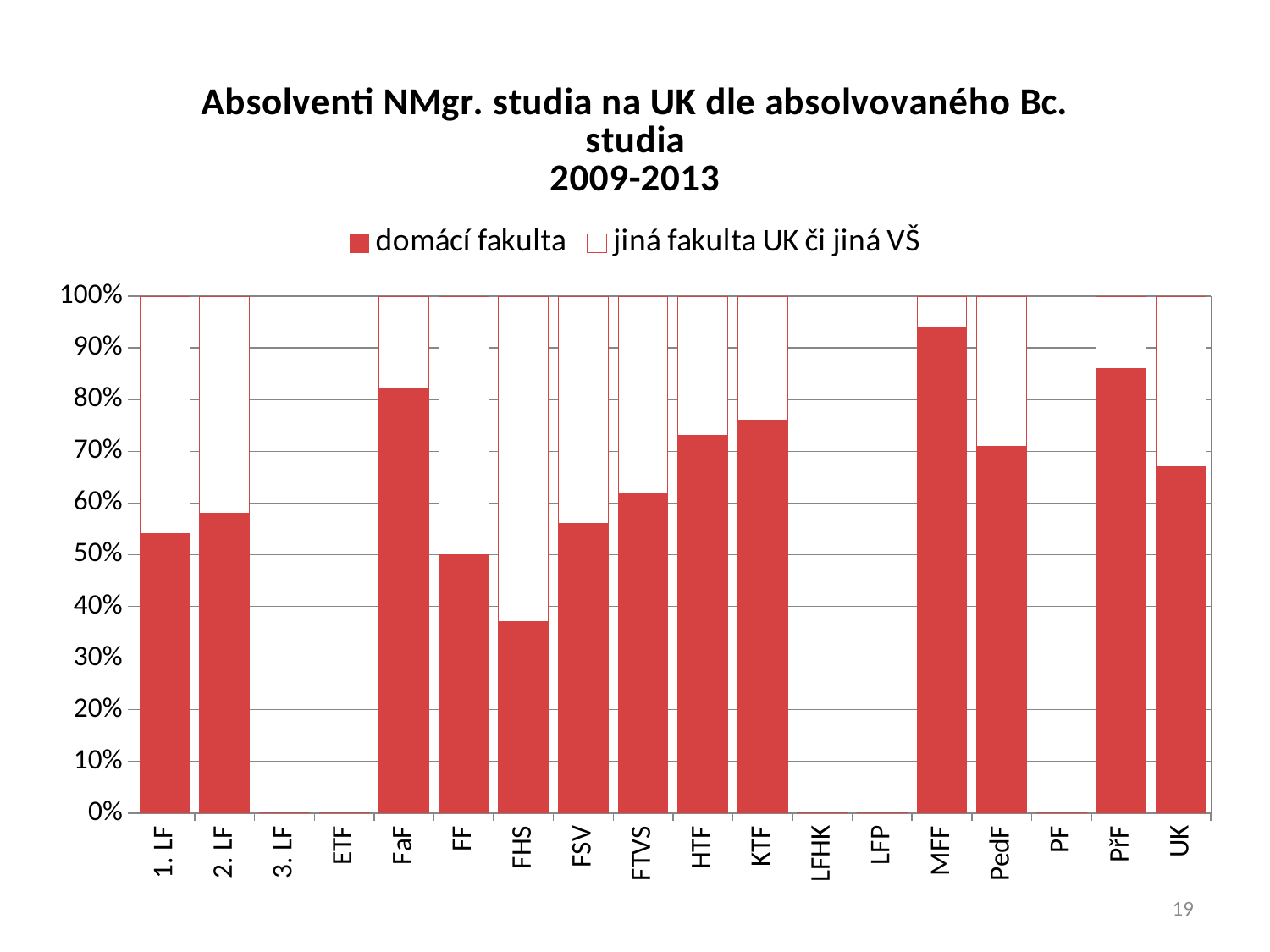
How many series does the legend list? 2 What is the total of the stacked bar for FaF? 100% How many categories are shown on the x axis? 18 Is the 'domácí fakulta' value for MFF greater or less than 90%? greater Is the 'domácí fakulta' value for FHS greater or less than 40%? less What kind of chart is shown on the slide? bar chart Which has the larger 'domácí fakulta' value, MFF or PřF? MFF Is the 'domácí fakulta' value for FaF greater or less than 80%? greater Which category has the highest value for 'domácí fakulta'? MFF Among the categories with a visible bar, which has the lowest value for 'domácí fakulta'? FHS Which has the larger 'domácí fakulta' value, FF or FHS? FF